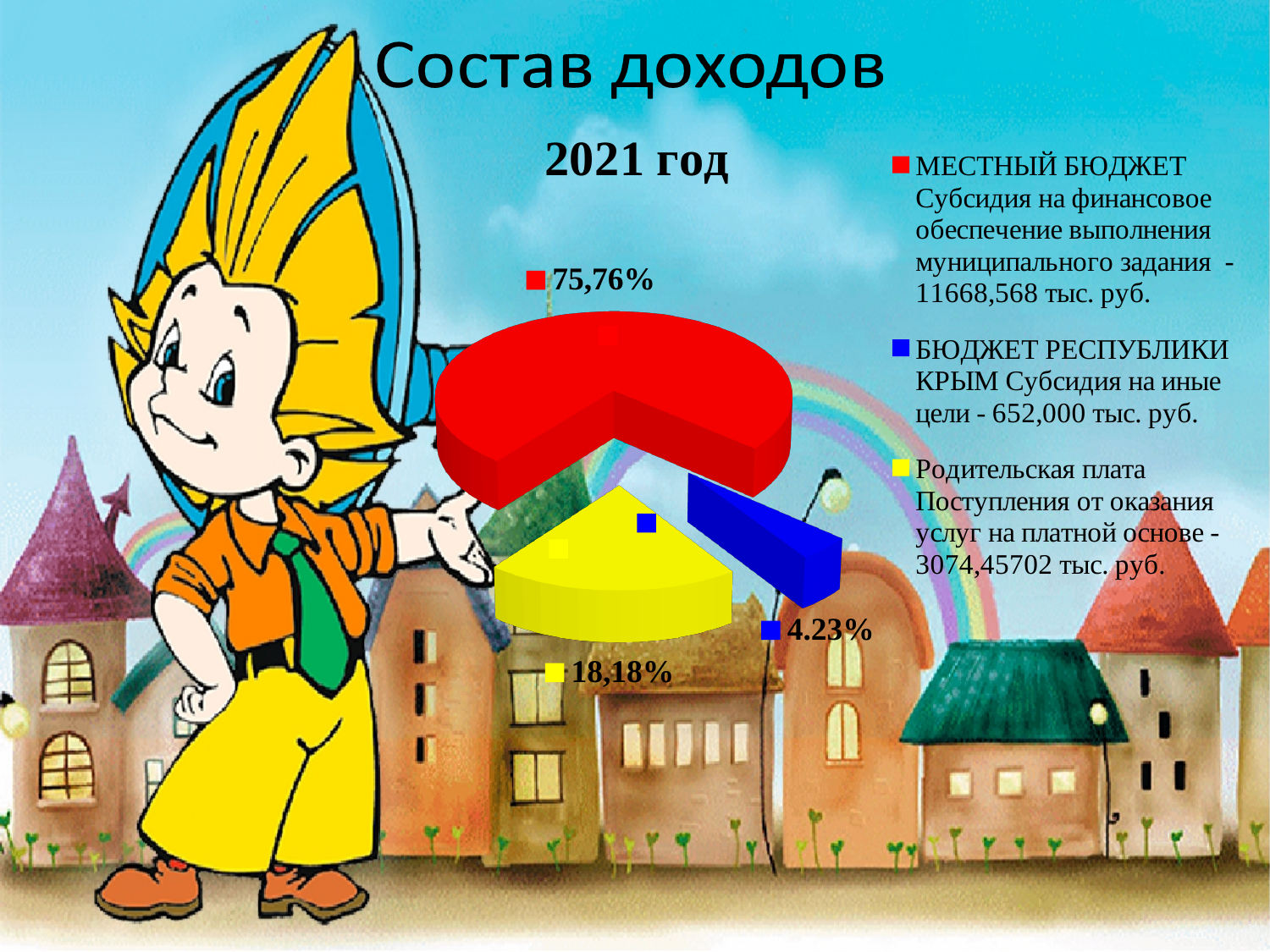
Which category has the smallest slice of the pie? БЮДЖЕТ РЕСПУБЛИКИ КРЫМ What amount in тыс. руб. does the legend give for БЮДЖЕТ РЕСПУБЛИКИ КРЫМ? 652,000 тыс. руб. Which category has the largest slice of the pie? МЕСТНЫЙ БЮДЖЕТ What colour is the slice for МЕСТНЫЙ БЮДЖЕТ? red By how many percentage points does the МЕСТНЫЙ БЮДЖЕТ share exceed the Родительская плата share? 57,58 What is the title shown above the pie chart? 2021 год What share of the pie does МЕСТНЫЙ БЮДЖЕТ account for? 75,76% How many slices does the pie chart have? 3 Which is larger: the slice for Родительская плата or the slice for БЮДЖЕТ РЕСПУБЛИКИ КРЫМ? Родительская плата What share of the pie does БЮДЖЕТ РЕСПУБЛИКИ КРЫМ account for? 4.23% What share of the pie does Родительская плата account for? 18,18% What kind of chart is shown on the slide? pie chart